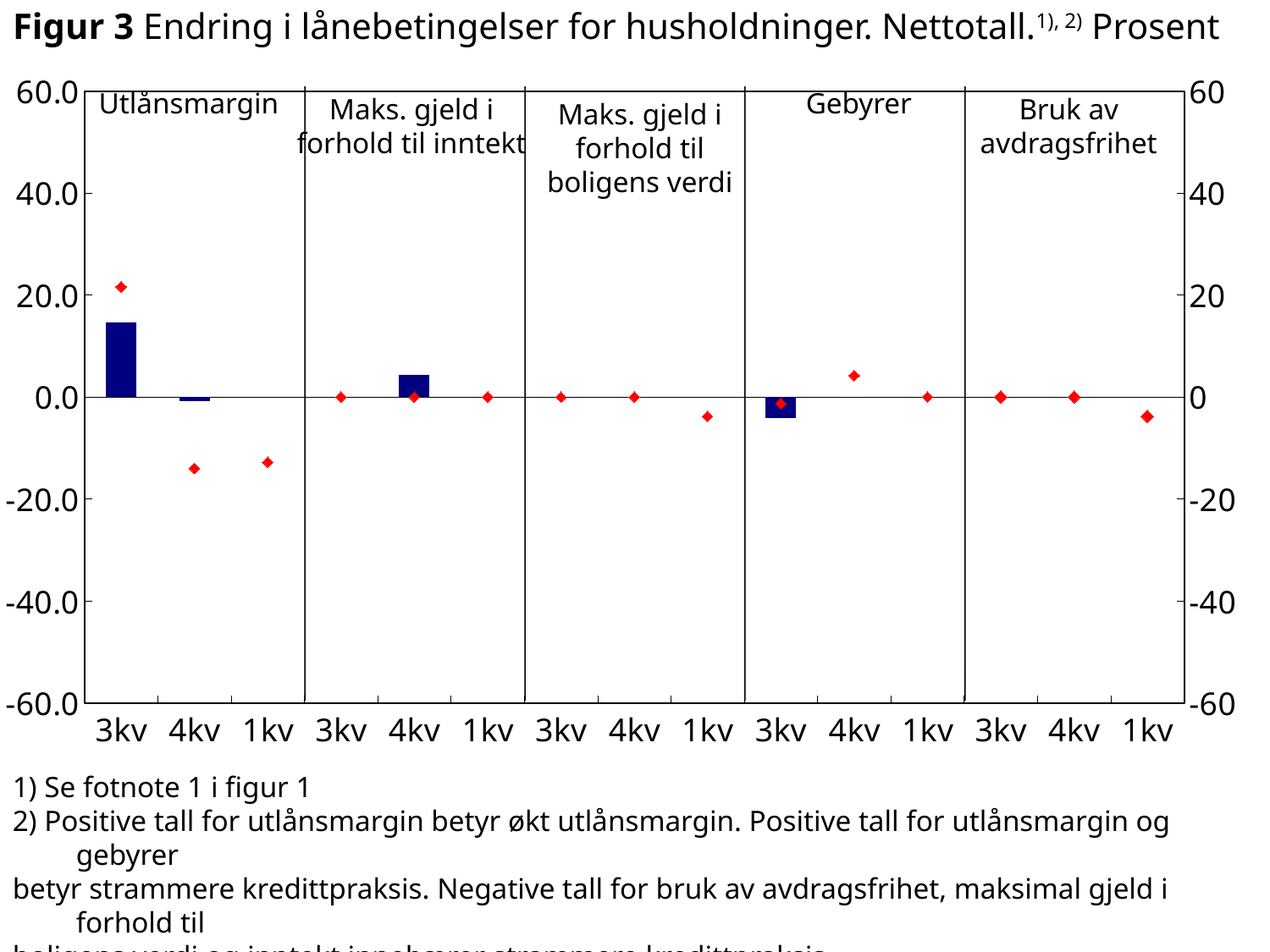
Is the bar for 3kv in the Gebyrer panel greater or less than 0? less What kind of chart is shown on the slide? combination bar and line chart (bars with red diamond markers) Is the bar for 3kv in the Utlånsmargin panel greater or less than 20? less Is the red marker for 3kv in the Utlånsmargin panel greater or less than 40? less In the Utlånsmargin panel, which quarter has the tallest bar? 3kv How many quarter labels are shown along the x axis in total? 15 Which is larger in the Utlånsmargin panel: the bar for 3kv or the bar for 4kv? 3kv Which panel contains the tallest bar in the chart? Utlånsmargin What is the title of the chart? Figur 3 Endring i lånebetingelser for husholdninger. Nettotall. Prosent How many panels (loan condition categories) does the chart have? 5